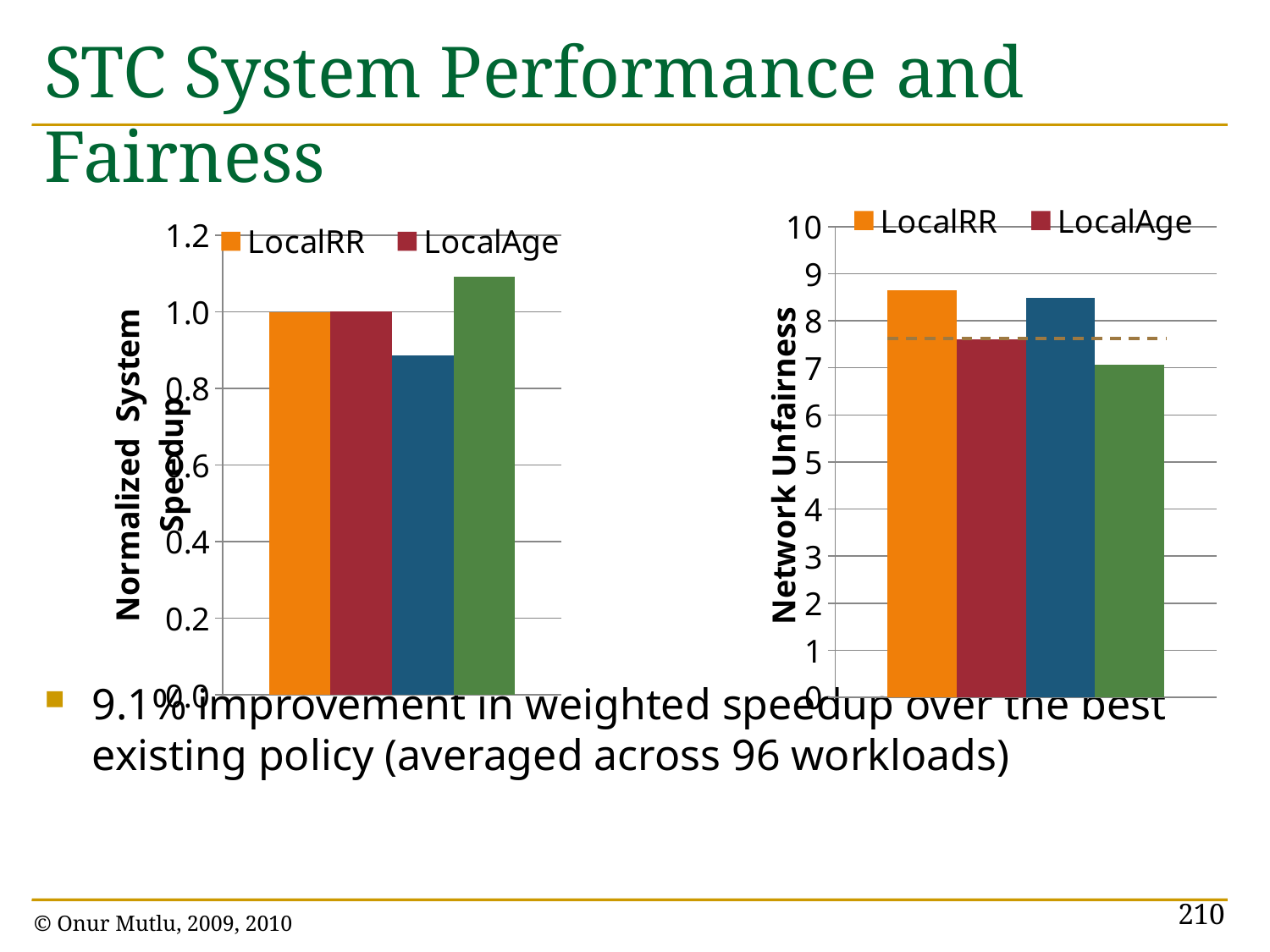
In the right chart (Network Unfairness), is the value for LocalAge greater or less than 8? less In the right chart (Network Unfairness), which is larger, LocalRR or LocalAge? LocalRR In the left chart (Normalized System Speedup), which colour bar is the tallest? green In the right chart (Network Unfairness), which colour bar is the shortest? green How many bars are plotted in the right chart (Network Unfairness)? 4 In the left chart (Normalized System Speedup), is the value of the blue bar greater or less than 1.0? less What type of chart is the left chart (Normalized System Speedup)? bar chart How many series does the legend of the left chart (Normalized System Speedup) list? 2 What type of chart is the right chart (Network Unfairness)? bar chart In the left chart (Normalized System Speedup), is the value of the green bar greater or less than 1.0? greater In the left chart (Normalized System Speedup), which colour bar is the shortest? blue